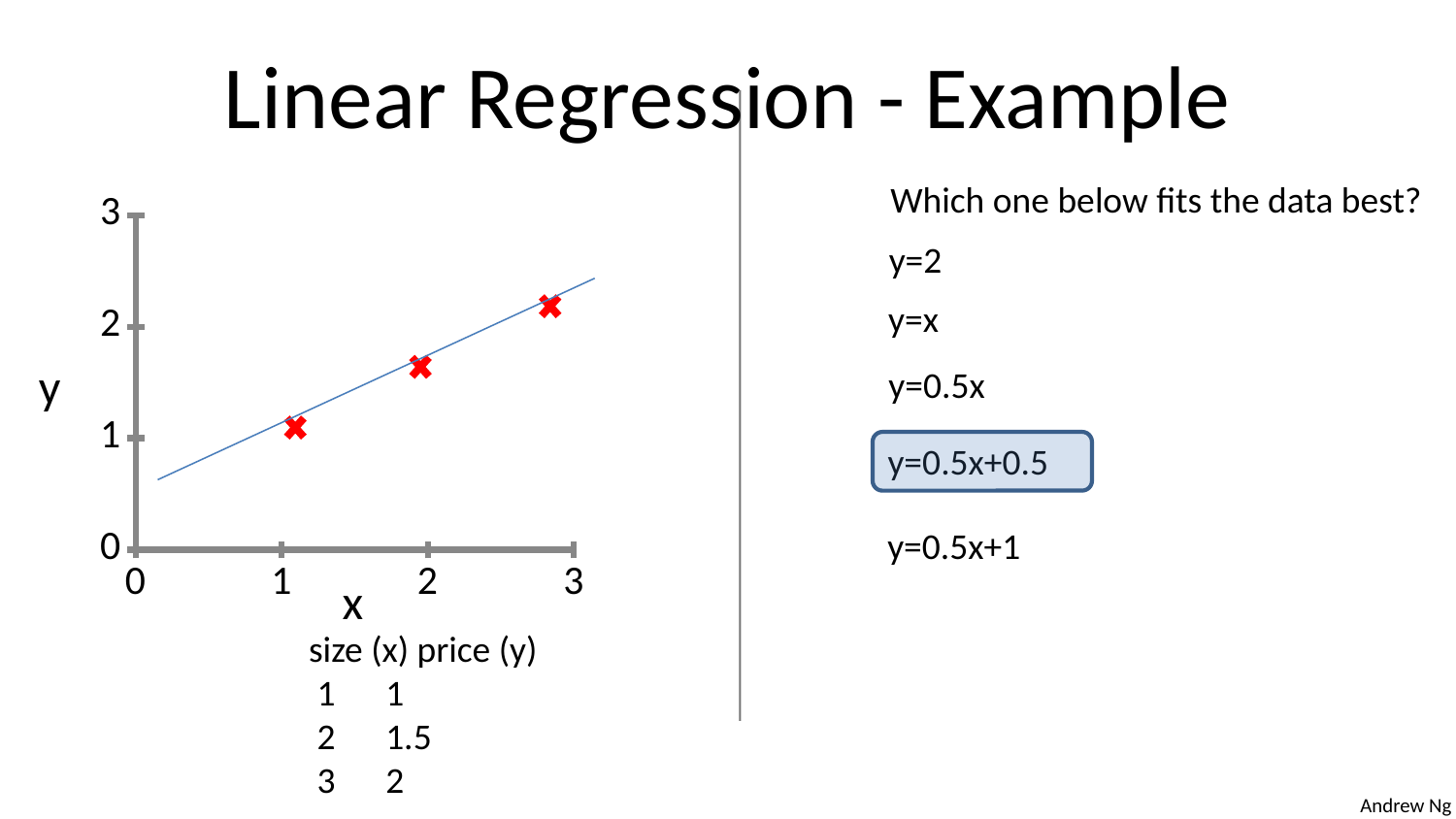
Is the plotted y value at x=1 greater or less than 2? less What is the label of the vertical axis of the chart? y At which size (x) is the price (y) highest? 3 How many data points are plotted on the chart? 3 What kind of chart is shown on the slide? scatter chart According to the data table, what is the price (y) when size (x) is 2? 1.5 What is the difference between the price at size 3 and the price at size 1? 1 Do the plotted y values rise or fall as x increases? rise At which size (x) is the price (y) lowest? 1 According to the data table, what is the price (y) when size (x) is 3? 2 According to the data table, what is the price (y) when size (x) is 1? 1 Which is larger, the price at size 2 or the price at size 1? size 2